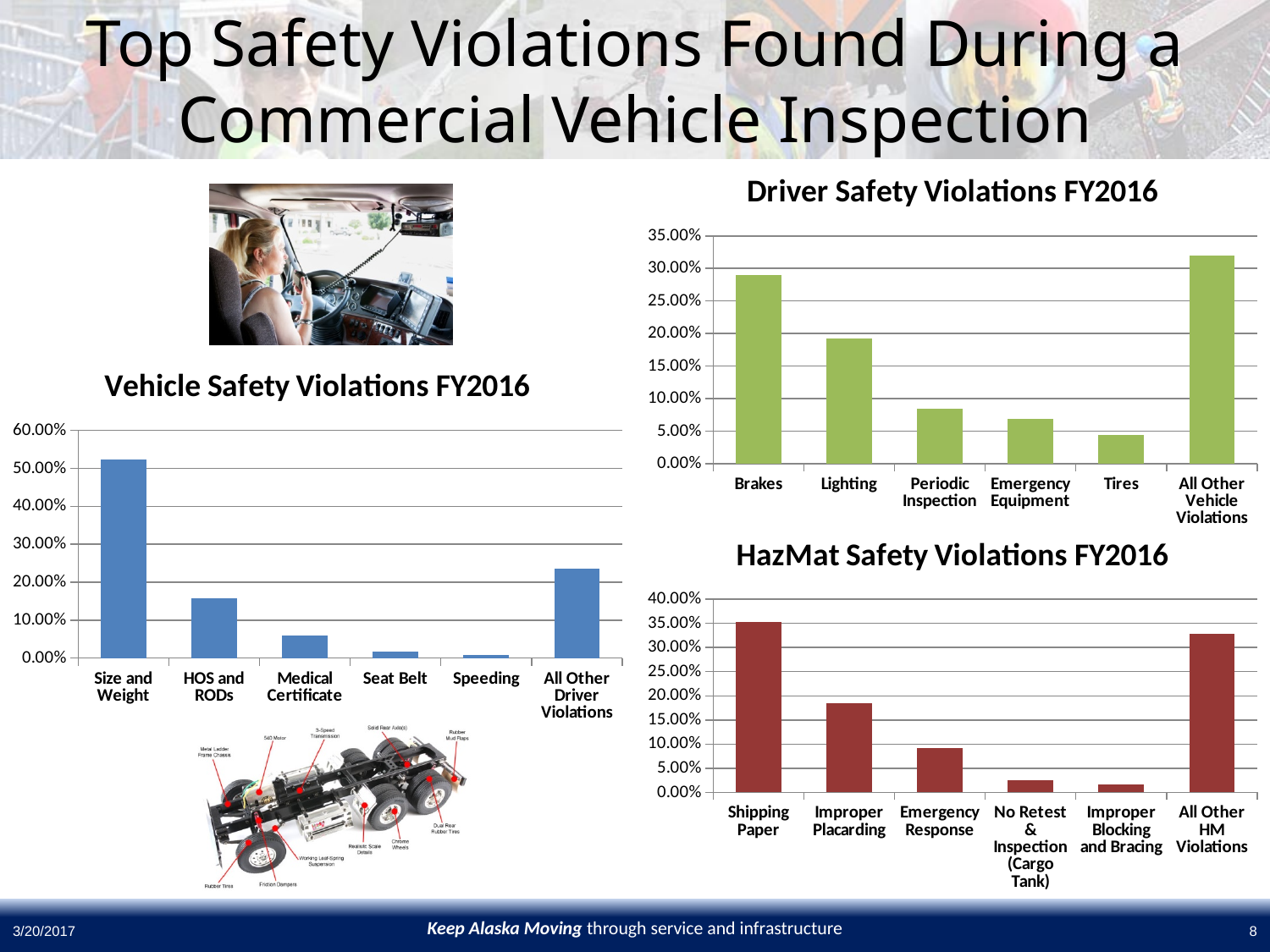
On the "Vehicle Safety Violations FY2016" chart, is the value for All Other Driver Violations greater or less than 20.00%? greater On the "Driver Safety Violations FY2016" chart, is the value for Brakes greater or less than 25.00%? greater On the "Vehicle Safety Violations FY2016" chart, which category has the highest value? Size and Weight How many categories are shown on the "HazMat Safety Violations FY2016" chart? 6 On the "Driver Safety Violations FY2016" chart, which is larger, Brakes or Lighting? Brakes On the "Driver Safety Violations FY2016" chart, which category has the highest value? All Other Vehicle Violations What kind of chart is the "Vehicle Safety Violations FY2016" chart? bar chart On the "Driver Safety Violations FY2016" chart, which category has the lowest value? Tires On the "HazMat Safety Violations FY2016" chart, which category has the lowest value? Improper Blocking and Bracing On the "Vehicle Safety Violations FY2016" chart, which category has the lowest value? Speeding On the "HazMat Safety Violations FY2016" chart, is the value for Improper Placarding greater or less than 20.00%? less What colour are the bars on the "HazMat Safety Violations FY2016" chart? dark red